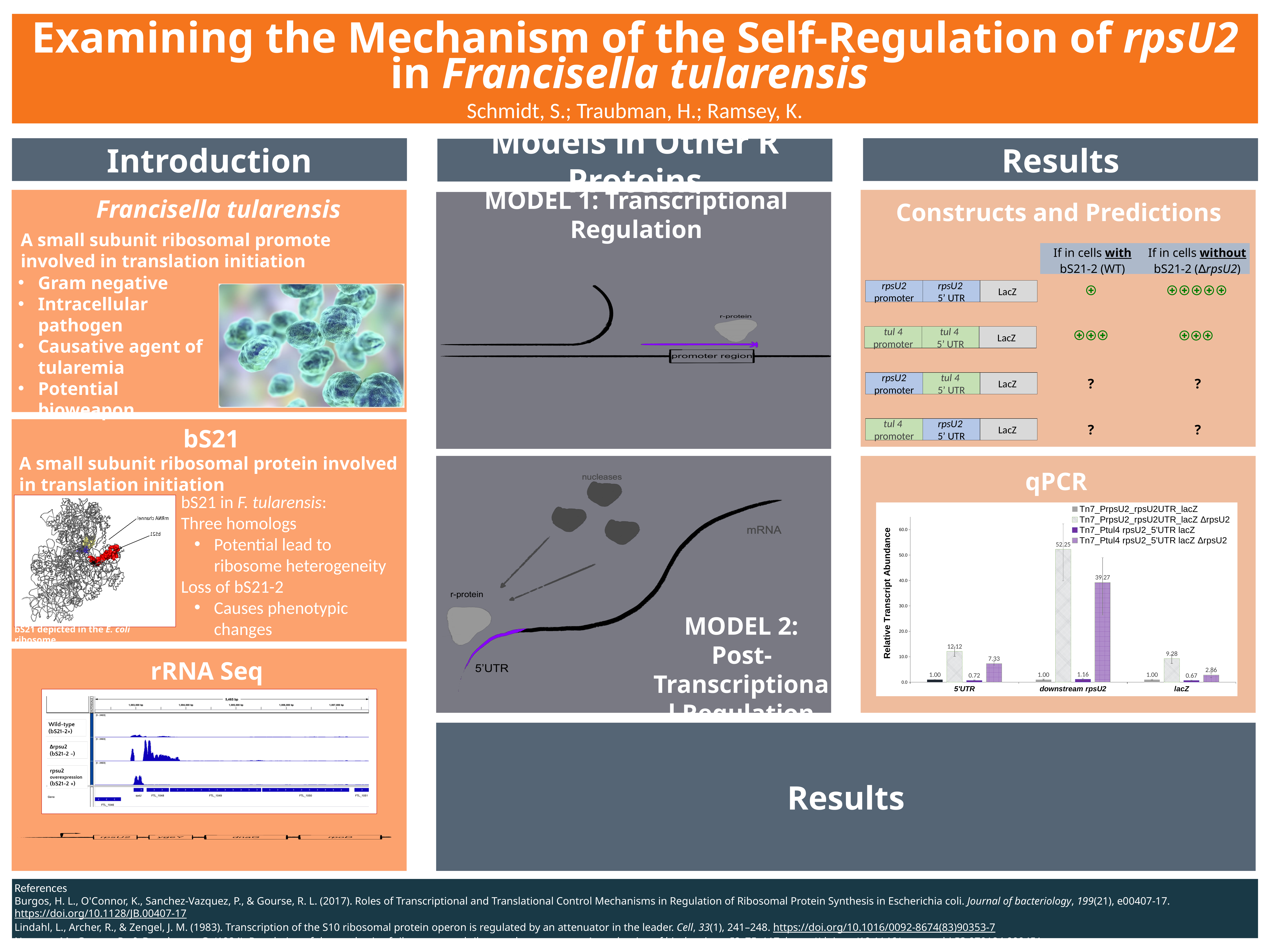
In the qPCR chart, which category has the highest value for Tn7_Ptul4 rpsU2_5'UTR lacZ ΔrpsU2? downstream rpsU2 In the qPCR chart, is the value for Tn7_Ptul4 rpsU2_5'UTR lacZ ΔrpsU2 in the downstream rpsU2 category greater or less than 30.0? greater In the qPCR chart, what is the value for Tn7_Ptul4 rpsU2_5'UTR lacZ ΔrpsU2 in the 5'UTR category? 7.33 How many categories are shown on the x axis of the qPCR chart? 3 In the qPCR chart, what is the difference between the Tn7_PrpsU2_rpsU2UTR_lacZ ΔrpsU2 and Tn7_Ptul4 rpsU2_5'UTR lacZ ΔrpsU2 values in the downstream rpsU2 category? 12.98 In the qPCR chart, what is the value for Tn7_PrpsU2_rpsU2UTR_lacZ ΔrpsU2 in the lacZ category? 9.28 In the qPCR chart, which is larger in the 5'UTR category: Tn7_PrpsU2_rpsU2UTR_lacZ ΔrpsU2 or Tn7_Ptul4 rpsU2_5'UTR lacZ ΔrpsU2? Tn7_PrpsU2_rpsU2UTR_lacZ ΔrpsU2 In the qPCR chart, which category has the lowest value for Tn7_PrpsU2_rpsU2UTR_lacZ ΔrpsU2? lacZ What kind of chart is the qPCR chart? bar chart In the qPCR chart, what is the value for Tn7_PrpsU2_rpsU2UTR_lacZ ΔrpsU2 in the downstream rpsU2 category? 52.25 How many series does the legend of the qPCR chart list? 4 In the qPCR chart, what is the value for Tn7_Ptul4 rpsU2_5'UTR lacZ in the lacZ category? 0.67